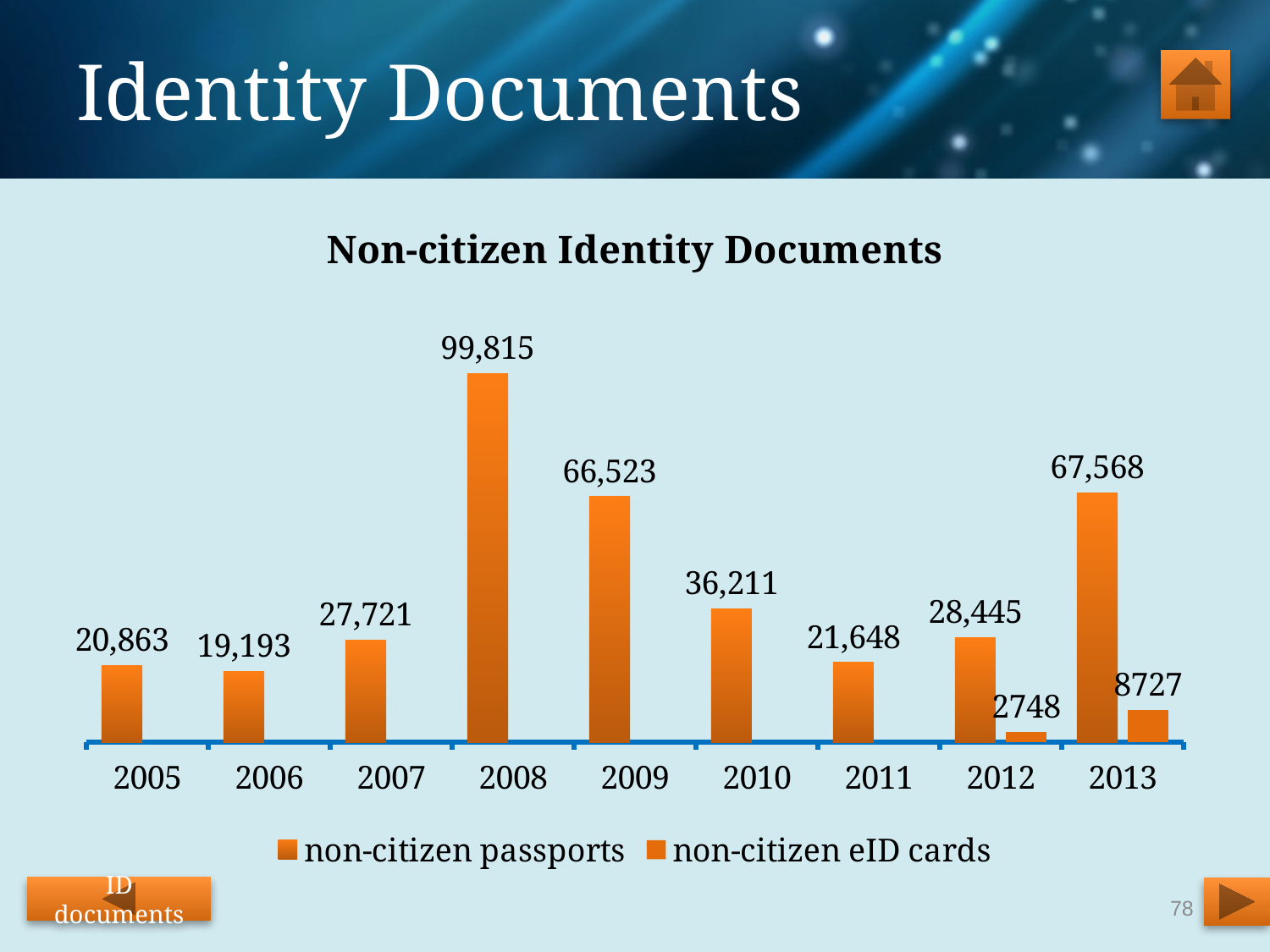
What is the value for non-citizen eID cards in 2012? 2748 How many years are shown on the x axis? 9 What is the value for non-citizen passports in 2013? 67,568 What is the value for non-citizen passports in 2008? 99,815 What is the value for non-citizen eID cards in 2013? 8727 How many series does the legend list? 2 Which is larger, non-citizen passports in 2010 or in 2012? 2010 In which year is the value for non-citizen passports lowest? 2006 What type of chart is shown on the slide? bar chart What is the title of the chart? Non-citizen Identity Documents What is the difference between non-citizen passports in 2008 and 2009? 33,292 In which year is the value for non-citizen passports highest? 2008